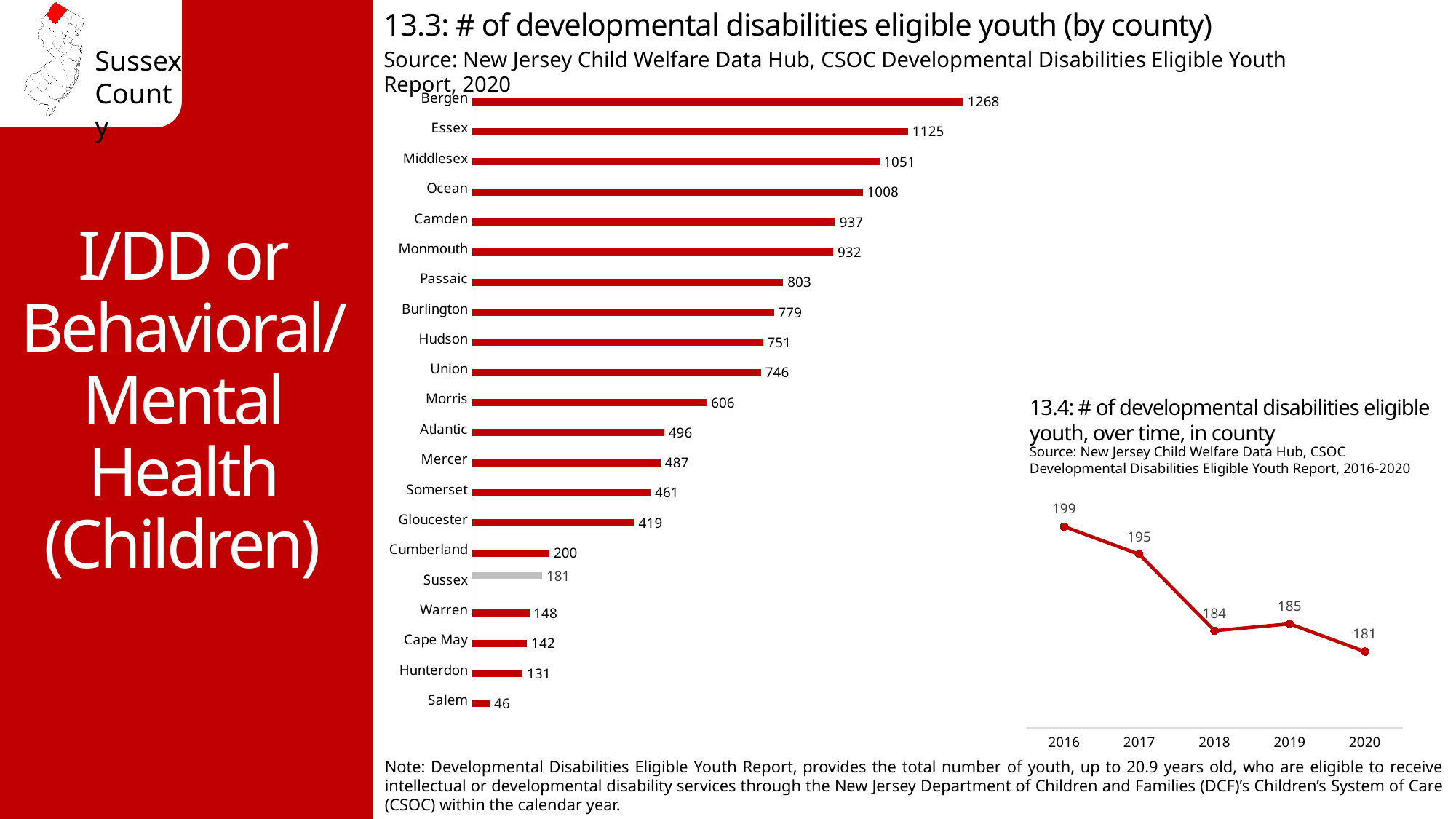
In the chart '13.3: # of developmental disabilities eligible youth (by county)', what is the value for Sussex? 181 In the chart '13.3: # of developmental disabilities eligible youth (by county)', which county has the lowest value? Salem What kind of chart is '13.3: # of developmental disabilities eligible youth (by county)'? Bar chart In the chart '13.3: # of developmental disabilities eligible youth (by county)', how many counties are shown? 21 In the chart '13.4: # of developmental disabilities eligible youth, over time, in county', what is the difference between the values for 2016 and 2020? 18 In the chart '13.3: # of developmental disabilities eligible youth (by county)', which county has the highest value? Bergen In the chart '13.4: # of developmental disabilities eligible youth, over time, in county', what is the value for 2018? 184 In the chart '13.3: # of developmental disabilities eligible youth (by county)', what is the value for Hunterdon? 131 In the chart '13.4: # of developmental disabilities eligible youth, over time, in county', which year has the highest value? 2016 In the chart '13.3: # of developmental disabilities eligible youth (by county)', what is the difference between the values for Bergen and Essex? 143 What kind of chart is '13.4: # of developmental disabilities eligible youth, over time, in county'? Line chart In the chart '13.3: # of developmental disabilities eligible youth (by county)', which is larger, the value for Morris or the value for Atlantic? Morris